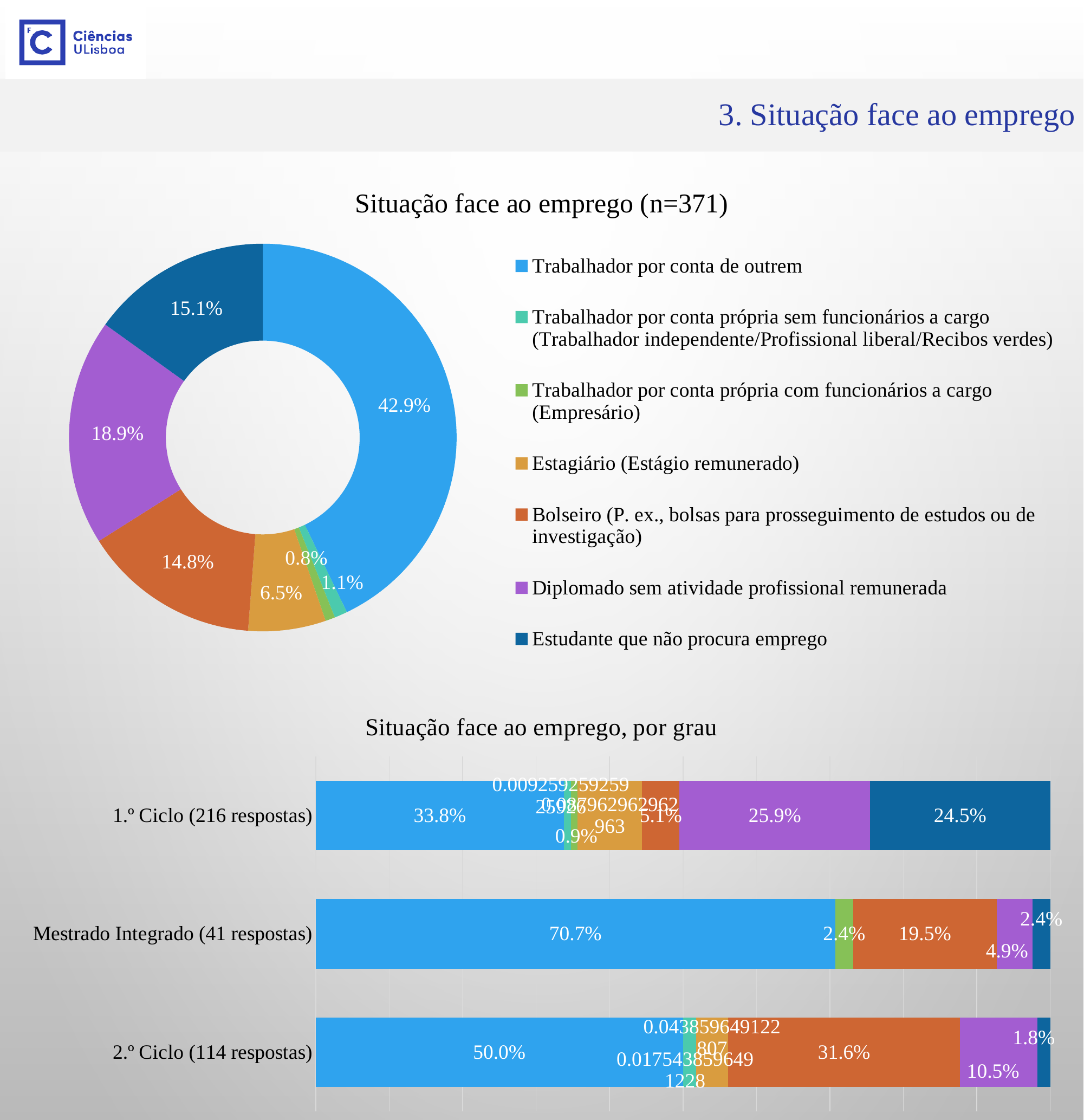
In the donut chart 'Situação face ao emprego (n=371)', which category has the smallest share? Trabalhador por conta própria com funcionários a cargo (Empresário) In the chart 'Situação face ao emprego, por grau', what is the 'Trabalhador por conta de outrem' share for 'Mestrado Integrado (41 respostas)'? 70.7% In the donut chart 'Situação face ao emprego (n=371)', what is the difference between the 'Bolseiro' share and the 'Estagiário (Estágio remunerado)' share? 8.3% In the donut chart 'Situação face ao emprego (n=371)', what share is 'Trabalhador por conta de outrem'? 42.9% In the donut chart 'Situação face ao emprego (n=371)', what share is 'Estudante que não procura emprego'? 15.1% In the donut chart 'Situação face ao emprego (n=371)', which category has the largest share? Trabalhador por conta de outrem In the donut chart 'Situação face ao emprego (n=371)', what share is 'Diplomado sem atividade profissional remunerada'? 18.9% What type of chart is 'Situação face ao emprego, por grau'? Stacked bar chart How many categories does the legend of the donut chart 'Situação face ao emprego (n=371)' list? 7 In the chart 'Situação face ao emprego, por grau', what is the 'Estudante que não procura emprego' share for '1.º Ciclo (216 respostas)'? 24.5% In the chart 'Situação face ao emprego, por grau', which degree has the largest 'Bolseiro' share: '2.º Ciclo (114 respostas)' or 'Mestrado Integrado (41 respostas)'? 2.º Ciclo (114 respostas) How many degree categories are shown in the chart 'Situação face ao emprego, por grau'? 3